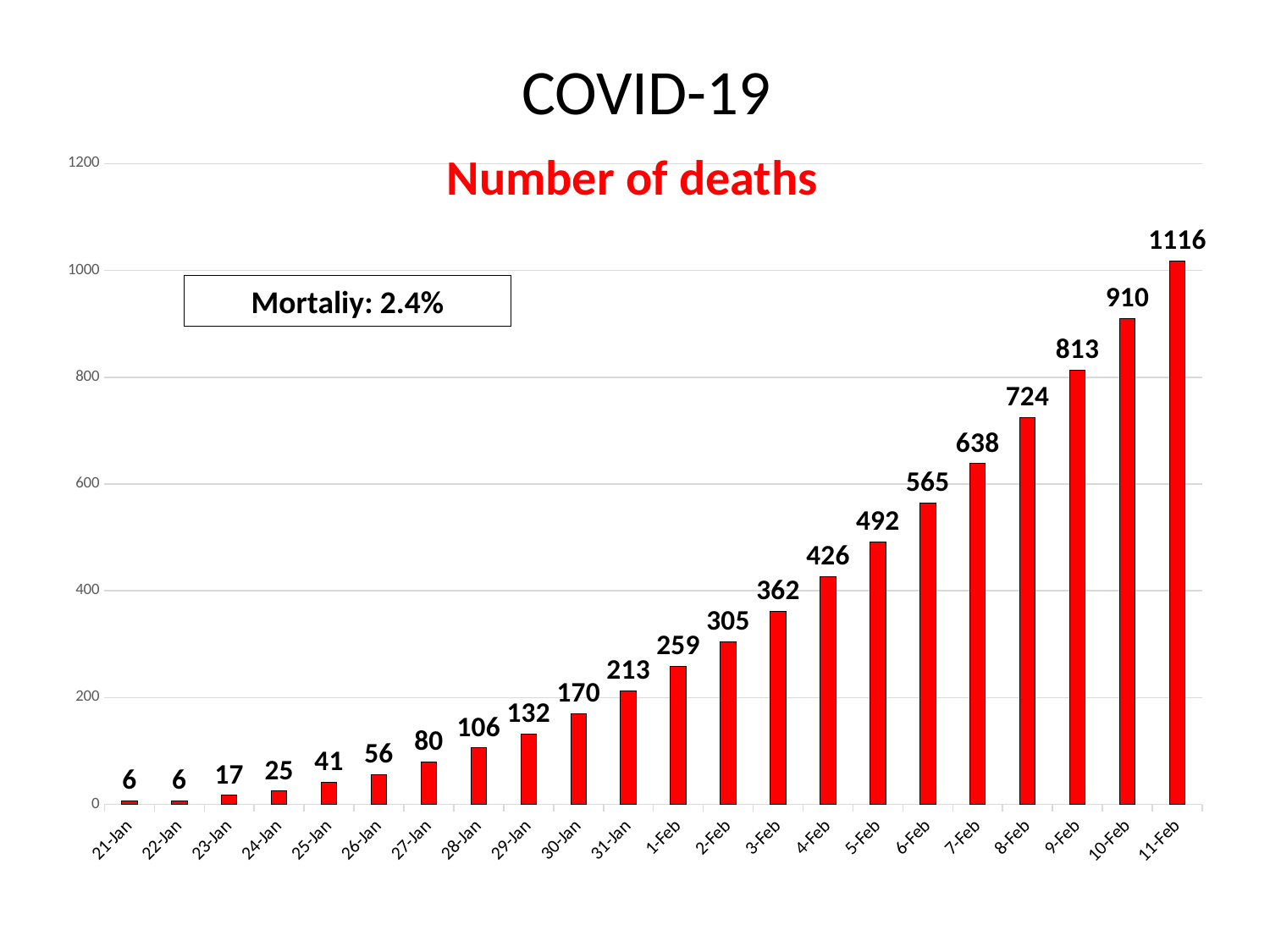
What is the number of deaths on 5-Feb? 492 Which is larger, the number of deaths on 7-Feb or on 6-Feb? 7-Feb Is the number of deaths on 8-Feb greater or less than 600? greater What kind of chart is shown on the slide? bar chart What is the number of deaths on 31-Jan? 213 How many dates are shown on the x axis? 22 What is the number of deaths on 11-Feb? 1116 What is the difference in the number of deaths between 10-Feb and 9-Feb? 97 Which date has the highest number of deaths? 11-Feb Do the number of deaths rise or fall from 21-Jan to 11-Feb? rise What is the difference in the number of deaths between 2-Feb and 1-Feb? 46 What mortality rate is stated in the box on the chart? 2.4%